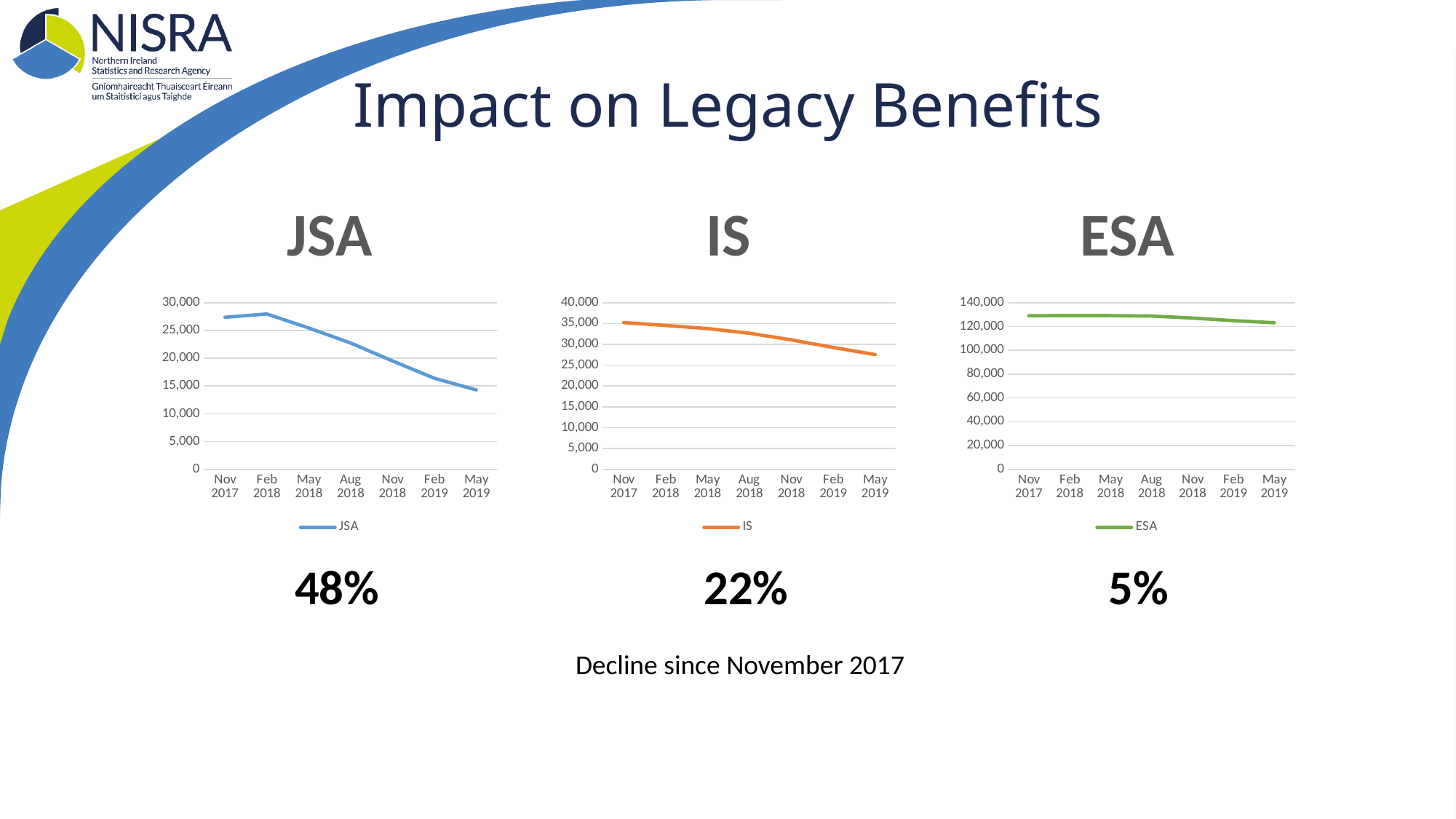
On the JSA chart, which period has the highest value? Feb 2018 What is the legend entry on the IS chart? IS On the IS chart, which period has the lowest value? May 2019 How many data points are plotted on the IS chart? 7 On the JSA chart, do the values rise or fall from Nov 2017 to May 2019 overall? fall On the JSA chart, which period has the lowest value? May 2019 How many series does the legend of the ESA chart list? 1 What kind of chart is the JSA chart? line chart On the ESA chart, is the value for Nov 2017 greater or less than 120,000? greater On the IS chart, do the values rise or fall along the x axis? fall On the JSA chart, is the value for Nov 2017 greater or less than 25,000? greater On the IS chart, is the value for May 2019 greater or less than 30,000? less